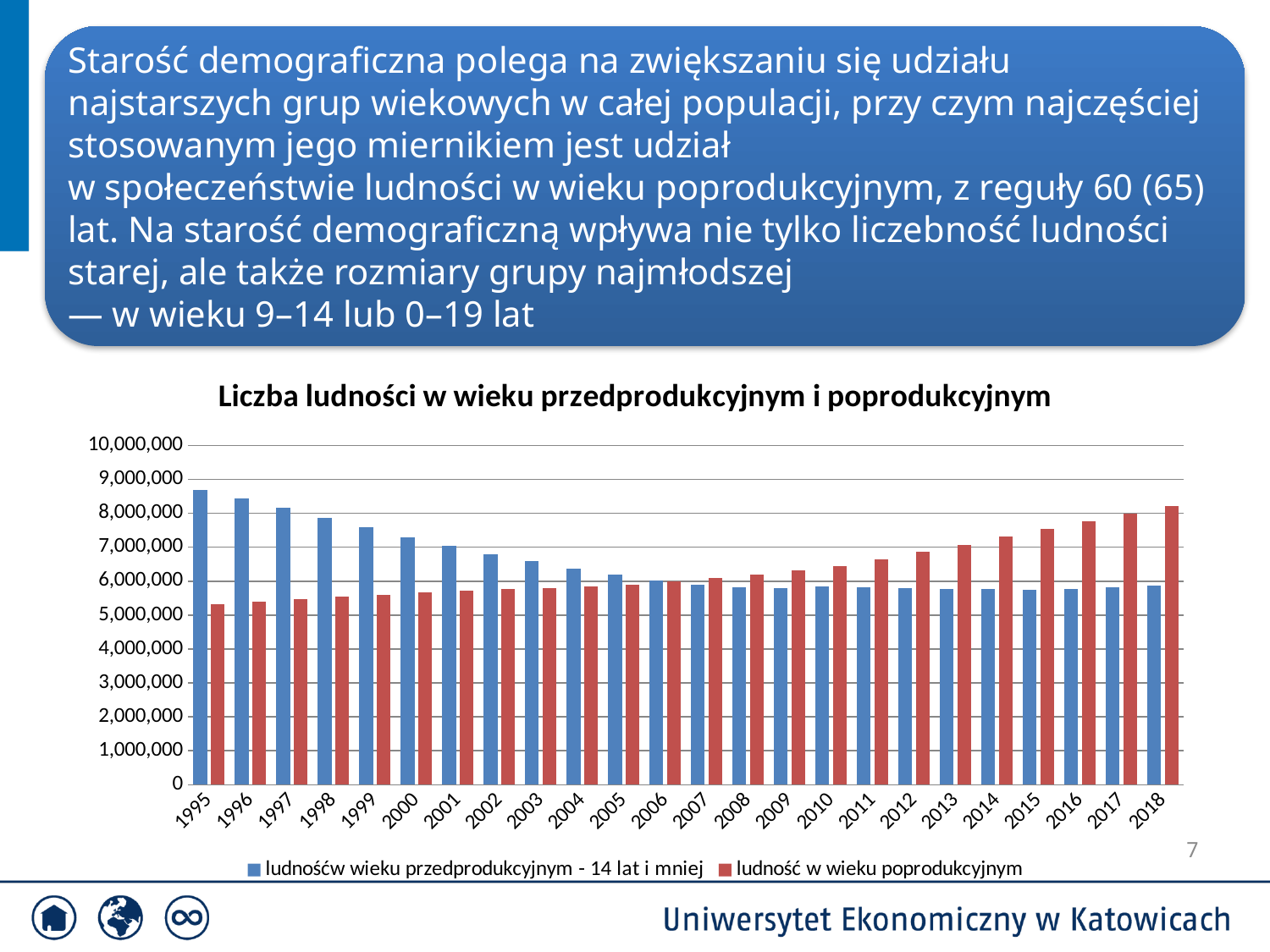
Does the value for 'ludność w wieku poprodukcyjnym' rise or fall from 1995 to 2018? rise Is the value for 'ludność w wieku przedprodukcyjnym - 14 lat i mniej' in 1995 greater or less than 8,000,000? greater Is the value for 'ludność w wieku poprodukcyjnym' in 1995 greater or less than 6,000,000? less How many years are shown on the x axis of the chart? 24 How many series does the chart legend list? 2 In which year is the value for 'ludność w wieku poprodukcyjnym' highest? 2018 In 2018, which series has the larger value: 'ludność w wieku przedprodukcyjnym - 14 lat i mniej' or 'ludność w wieku poprodukcyjnym'? ludność w wieku poprodukcyjnym In which year is the value for 'ludność w wieku poprodukcyjnym' lowest? 1995 In which year is the value for 'ludność w wieku przedprodukcyjnym - 14 lat i mniej' highest? 1995 What kind of chart is shown on the slide? bar chart Which colour represents 'ludność w wieku poprodukcyjnym' in the chart? red What is the title of the chart? Liczba ludności w wieku przedprodukcyjnym i poprodukcyjnym